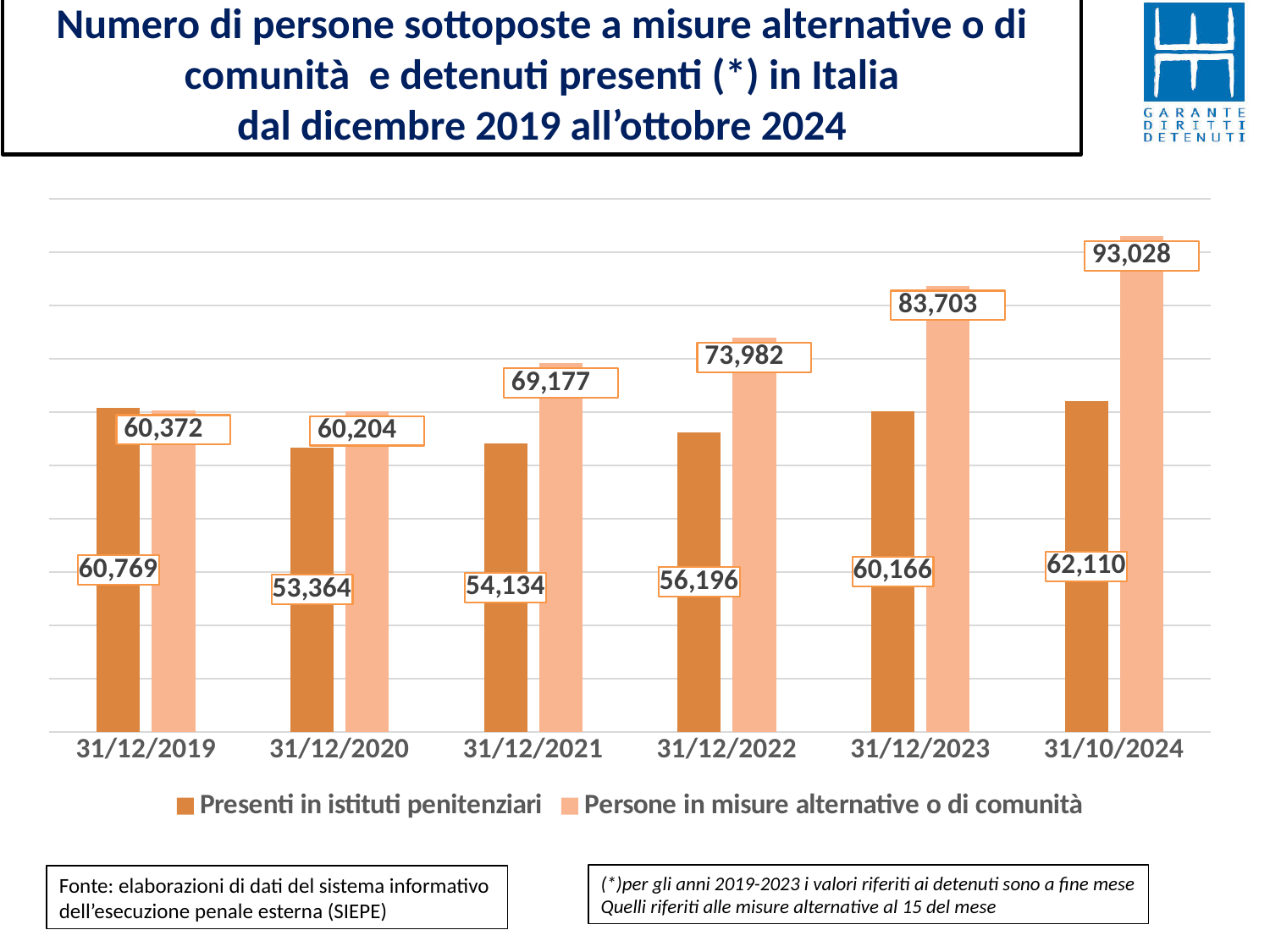
How many series does the legend list? 2 What kind of chart is shown on the slide? Bar chart On which date is the value for "Persone in misure alternative o di comunità" highest? 31/10/2024 Which series is shown in the darker orange colour? Presenti in istituti penitenziari On which date is the value for "Presenti in istituti penitenziari" lowest? 31/12/2020 On 31/12/2019, which is larger: "Presenti in istituti penitenziari" or "Persone in misure alternative o di comunità"? Presenti in istituti penitenziari What is the value for "Persone in misure alternative o di comunità" on 31/12/2022? 73,982 What is the value for "Presenti in istituti penitenziari" on 31/10/2024? 62,110 What is the difference between "Persone in misure alternative o di comunità" and "Presenti in istituti penitenziari" on 31/10/2024? 30,918 What is the value for "Presenti in istituti penitenziari" on 31/12/2021? 54,134 Does the value for "Persone in misure alternative o di comunità" rise or fall from 31/12/2020 to 31/10/2024? Rise How many dates are shown on the x axis? 6